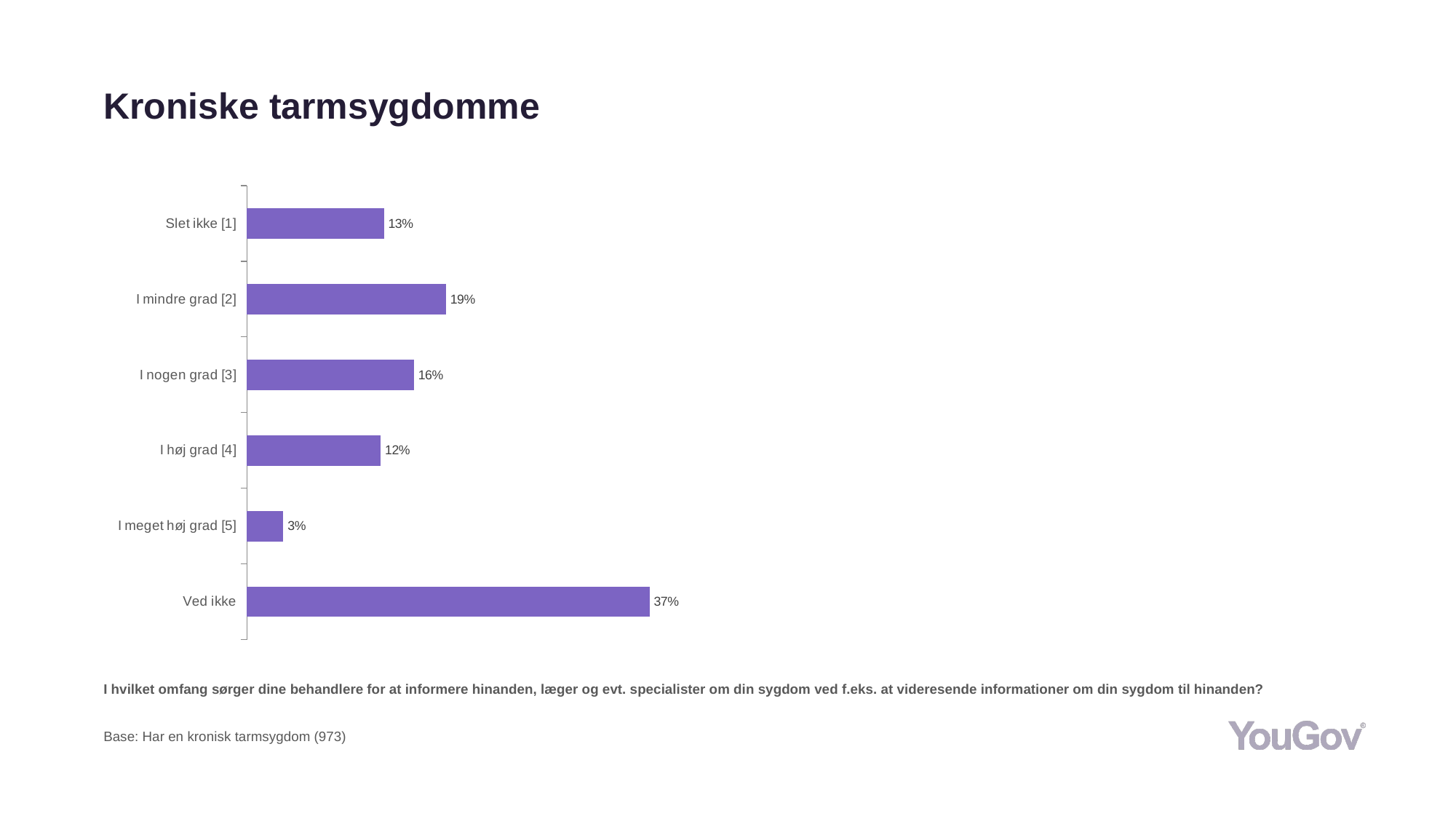
What is the value for "I meget høj grad [5]"? 3% What kind of chart is shown on the slide? Bar chart How many categories are shown in the chart? 6 What is the value for "I mindre grad [2]"? 19% What is the difference between the values for "Slet ikke [1]" and "I høj grad [4]"? 1% Which is larger, the value for "I nogen grad [3]" or the value for "I høj grad [4]"? I nogen grad [3] What is the value for "Ved ikke"? 37% What is the difference between the values for "Ved ikke" and "I mindre grad [2]"? 18% Which category has the highest value? Ved ikke What is the title of the slide? Kroniske tarmsygdomme Which category has the lowest value? I meget høj grad [5] What is the value for "I nogen grad [3]"? 16%